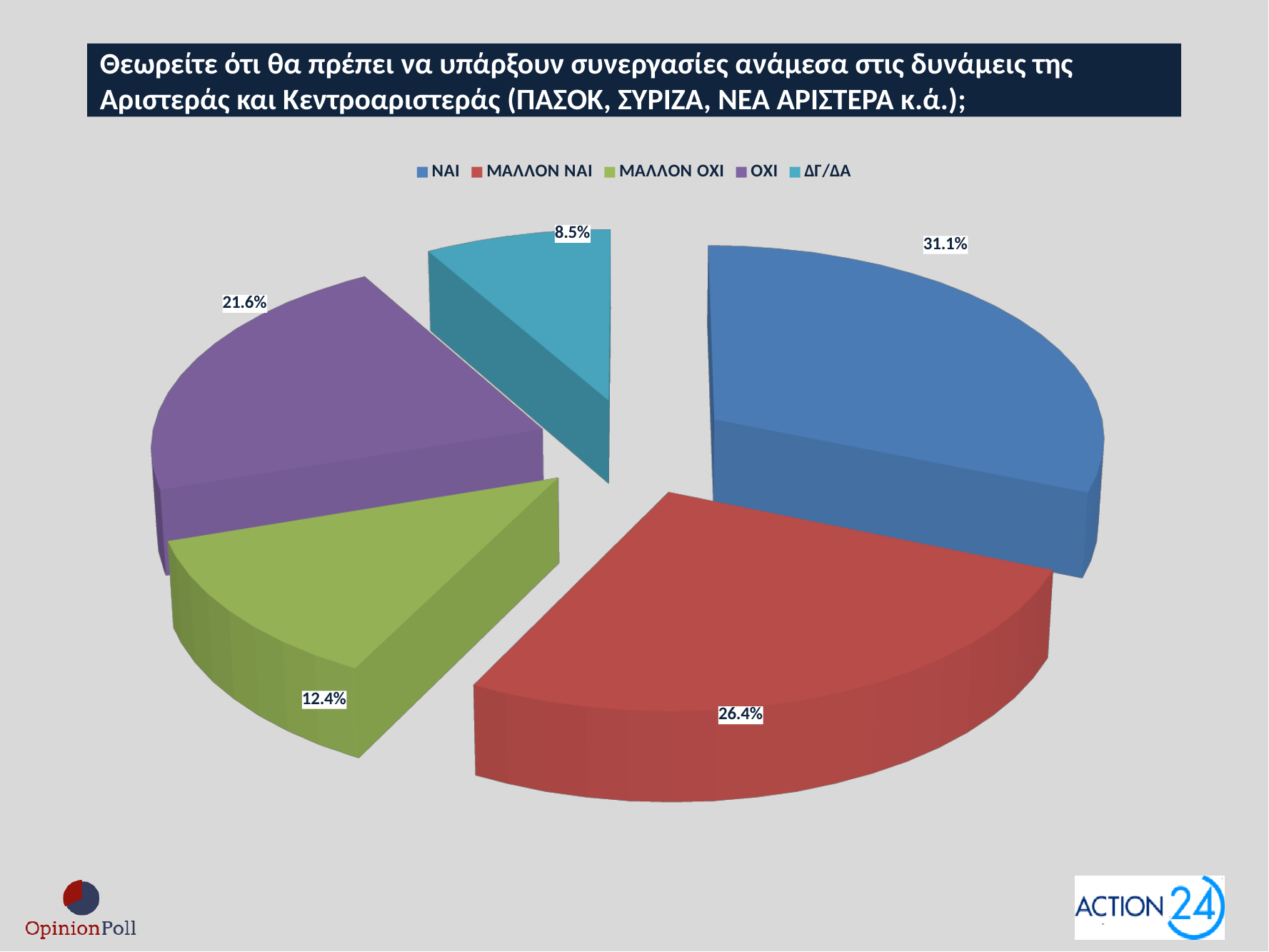
Which category has the smallest share? ΔΓ/ΔΑ What kind of chart is shown on the slide? Pie chart Which is larger, the value for ΟΧΙ or the value for ΜΑΛΛΟΝ ΟΧΙ? ΟΧΙ What is the value for ΟΧΙ? 21.6% Which category has the largest share? ΝΑΙ What is the value for ΝΑΙ? 31.1% What is the difference between the values for ΝΑΙ and ΜΑΛΛΟΝ ΝΑΙ? 4.7% What is the value for ΜΑΛΛΟΝ ΝΑΙ? 26.4% What is the value for ΔΓ/ΔΑ? 8.5% What colour is the ΜΑΛΛΟΝ ΝΑΙ slice? Red What is the value for ΜΑΛΛΟΝ ΟΧΙ? 12.4% How many categories does the pie chart show? 5